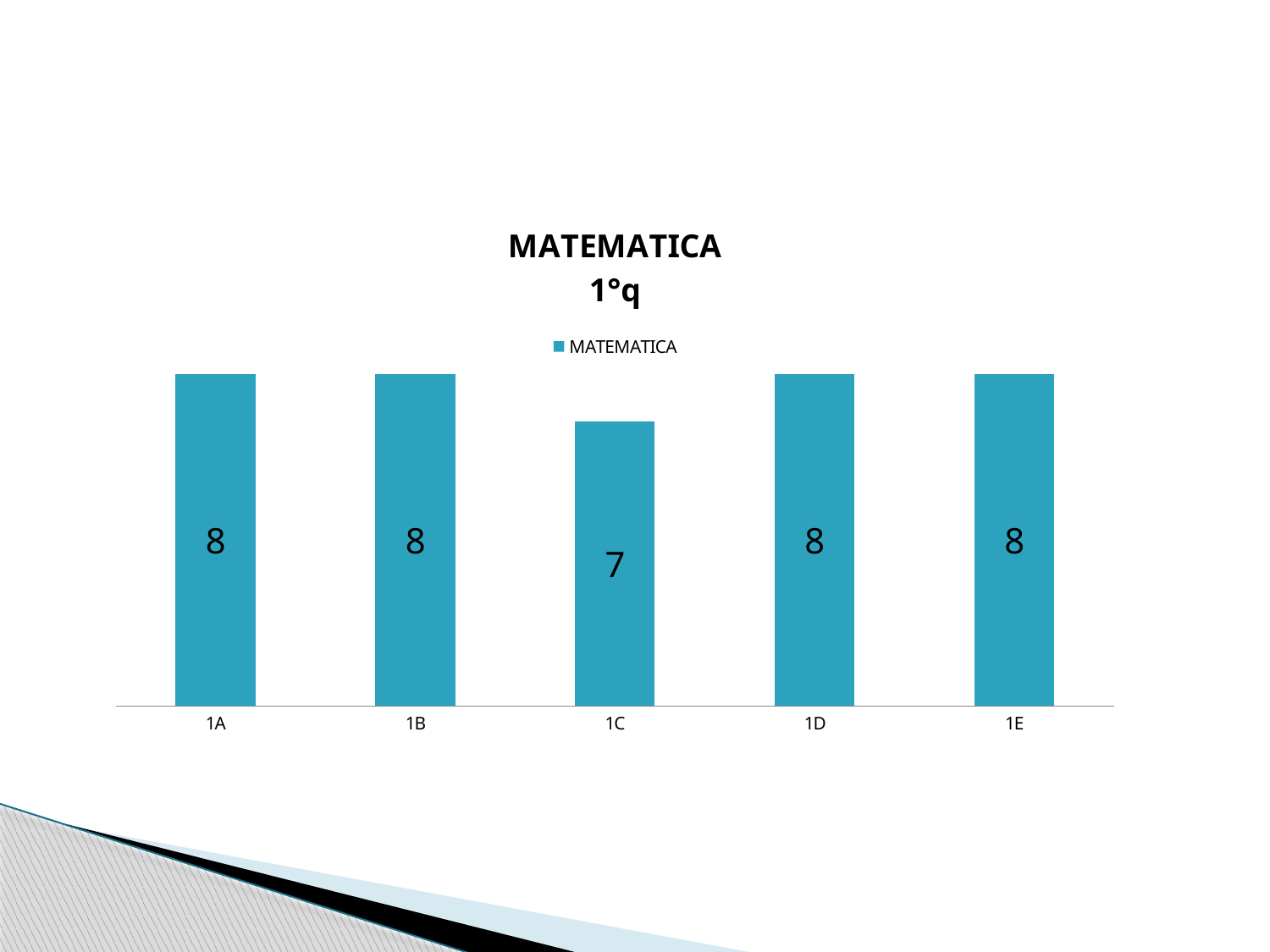
What is the difference between the values for 1B and 1C? 1 What is the value for 1A? 8 What series name is shown in the legend? MATEMATICA What kind of chart is shown? bar chart Which category has the lowest value? 1C How many categories have a value of 8? 4 How many series does the legend list? 1 Which is larger, the value for 1D or the value for 1C? 1D How many categories are shown on the x axis? 5 What is the value for 1C? 7 What is the title of the chart? MATEMATICA 1°q What is the value for 1E? 8